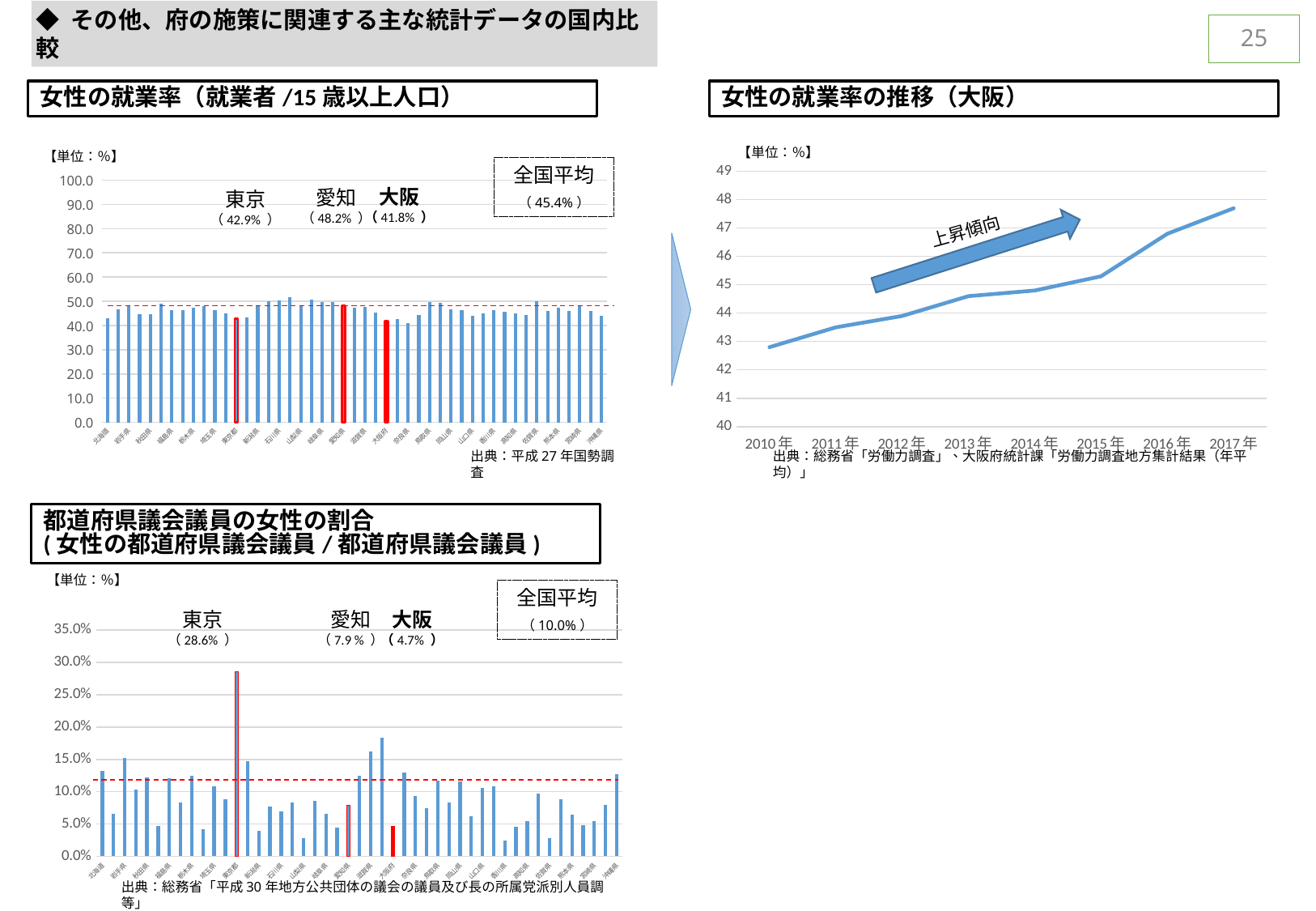
In the 都道府県議会議員の女性の割合 chart, what is the value for 東京? 28.6% In the 都道府県議会議員の女性の割合 chart, what is the difference between the values for 東京 and 大阪? 23.9 percentage points In the 女性の就業率（就業者/15歳以上人口） chart, what is the difference between the values for 愛知 and 大阪? 6.4 percentage points How many years are plotted in the 女性の就業率の推移（大阪） chart? 8 In the 女性の就業率（就業者/15歳以上人口） chart, what is the value for 大阪? 41.8% In the 都道府県議会議員の女性の割合 chart, which is larger, the value for 愛知 or the value for 大阪? 愛知 In the 女性の就業率（就業者/15歳以上人口） chart, what is the 全国平均 shown? 45.4% In the 女性の就業率の推移（大阪） chart, is the value for 2017年 greater or less than 47? greater In the 女性の就業率（就業者/15歳以上人口） chart, what is the value for 愛知? 48.2% What kind of chart is the 女性の就業率の推移（大阪） chart? line chart In the 女性の就業率の推移（大阪） chart, do the values rise or fall from 2010年 to 2017年? rise In the 女性の就業率（就業者/15歳以上人口） chart, which is larger, the value for 東京 or the value for 大阪? 東京